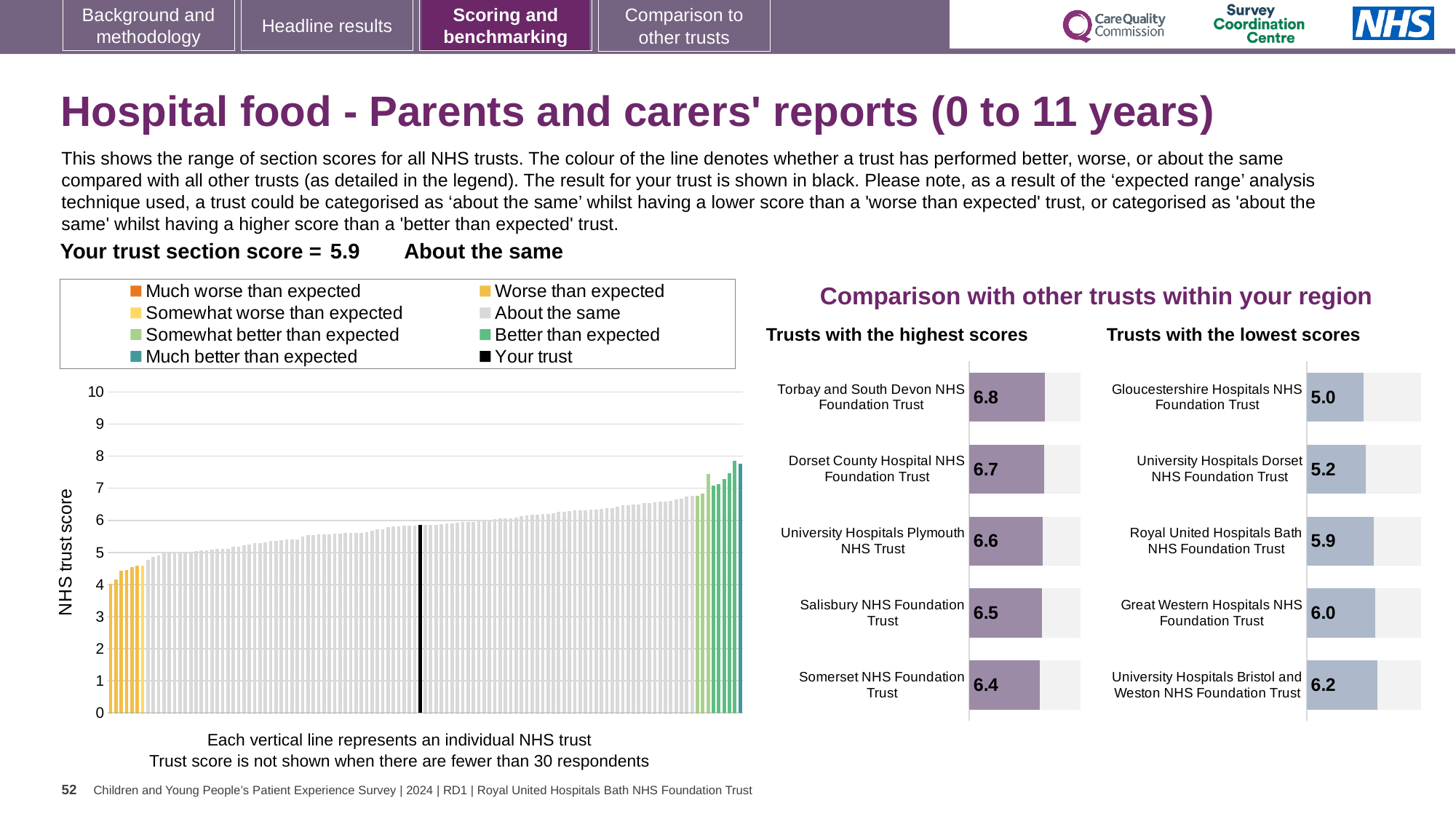
In the large 'NHS trust score' chart on the left, is the value of the tallest bar greater or less than 7? greater In the large 'NHS trust score' chart on the left, do the bar values rise or fall from left to right? Rise In the 'Trusts with the lowest scores' chart, what is the difference between the scores of University Hospitals Bristol and Weston NHS Foundation Trust and Gloucestershire Hospitals NHS Foundation Trust? 1.2 What kind of chart is the large 'NHS trust score' chart on the left of the slide? Bar chart In the 'Trusts with the lowest scores' chart, what is the score for Gloucestershire Hospitals NHS Foundation Trust? 5.0 How many entries does the legend above the large 'NHS trust score' chart list? 8 How many trusts are shown in the 'Trusts with the highest scores' chart? 5 In the 'Trusts with the highest scores' chart, which trust has the highest score? Torbay and South Devon NHS Foundation Trust In the 'Trusts with the highest scores' chart, what is the difference between the scores of Torbay and South Devon NHS Foundation Trust and Somerset NHS Foundation Trust? 0.4 Which has the higher score: Salisbury NHS Foundation Trust in the highest scores chart or Great Western Hospitals NHS Foundation Trust in the lowest scores chart? Salisbury NHS Foundation Trust In the 'Trusts with the highest scores' chart, what is the score for Torbay and South Devon NHS Foundation Trust? 6.8 In the 'Trusts with the lowest scores' chart, which trust has the lowest score? Gloucestershire Hospitals NHS Foundation Trust